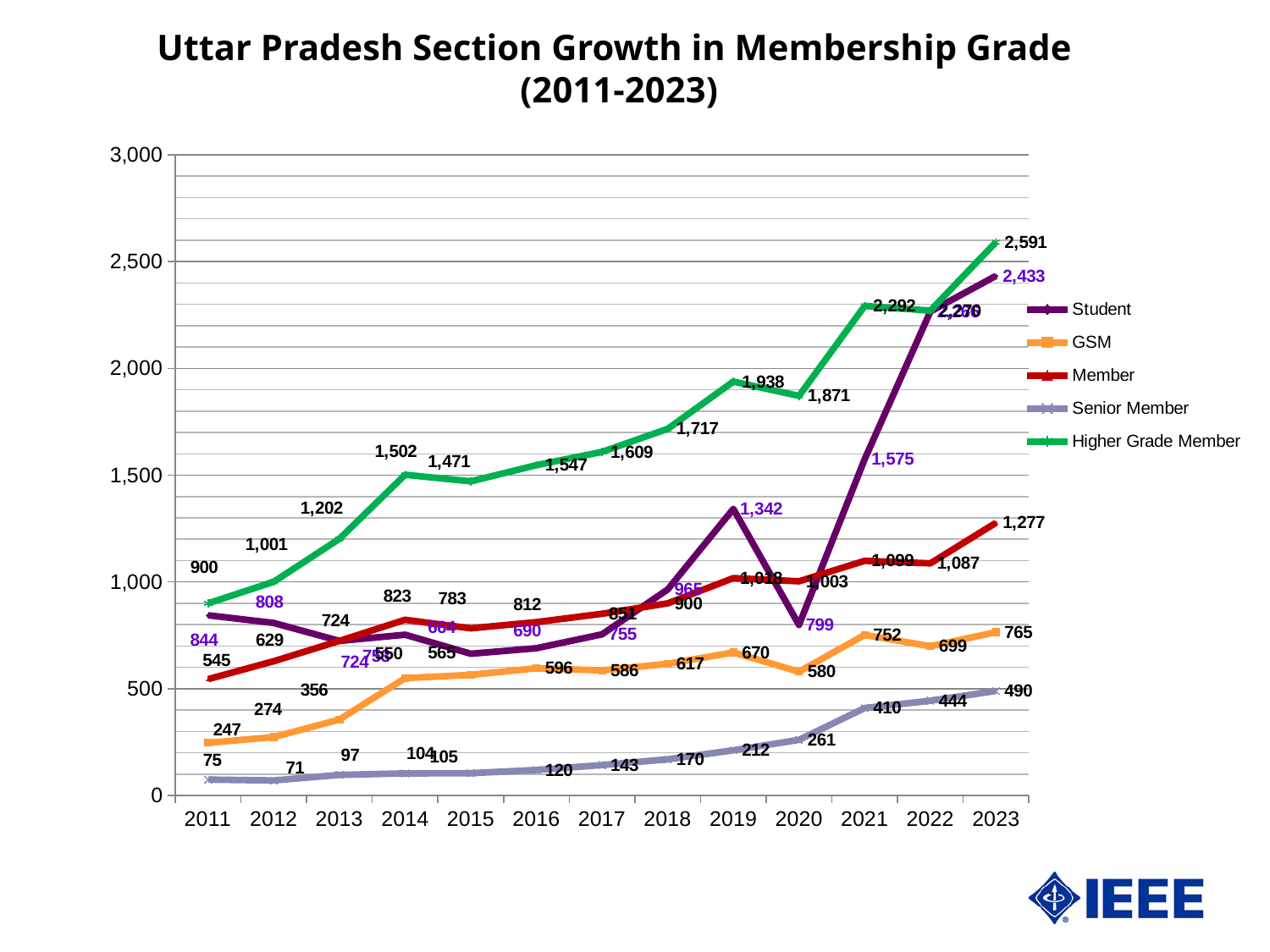
In which year is the Higher Grade Member value highest? 2023 What is the Student value for 2023? 2,433 How many years are plotted along the x axis? 13 How many series does the legend list? 5 What is the Higher Grade Member value for 2023? 2,591 What is the Senior Member value for 2011? 75 Does the Senior Member series generally rise or fall from 2011 to 2023? rise What is the GSM value for 2021? 752 Which is larger in 2019, the Student value or the Member value? Student In which year is the Senior Member value lowest? 2012 What is the difference between the Member value in 2023 and in 2011? 732 What kind of chart is shown on the slide? line chart